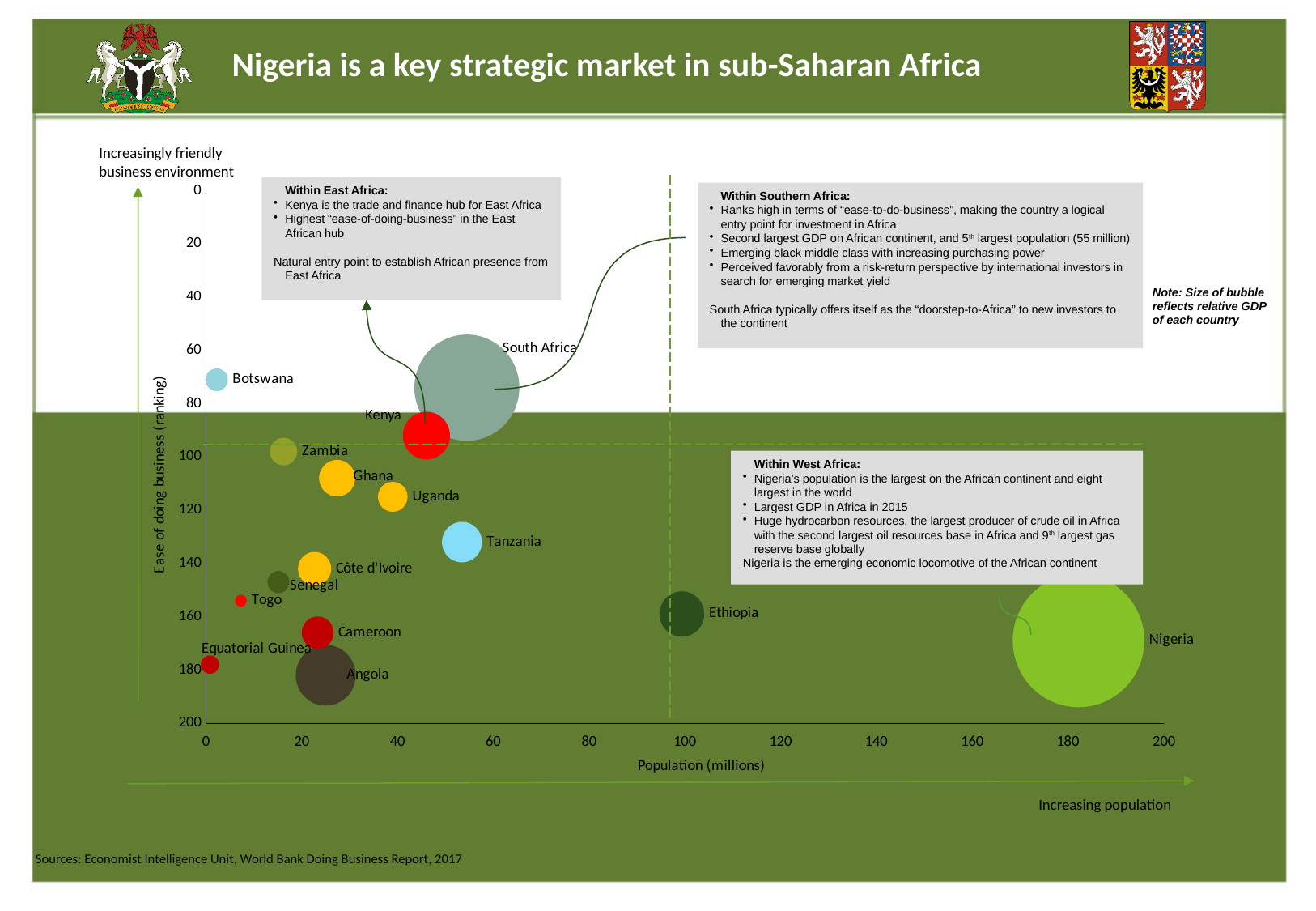
Is the population value for Nigeria greater or less than 160 million? greater What does the x axis of the chart represent? Population (millions) How many countries are plotted as bubbles on the chart? 15 Which has the larger population, Nigeria or Ethiopia? Nigeria Which country has the largest population on the chart? Nigeria Is the ease of doing business ranking for Angola greater or less than 160? greater Is the population value for Botswana greater or less than 20 million? less According to the note on the slide, what does the size of each bubble reflect? Relative GDP of each country Which has the larger population, Tanzania or Ghana? Tanzania What kind of chart is shown on the slide? Bubble chart